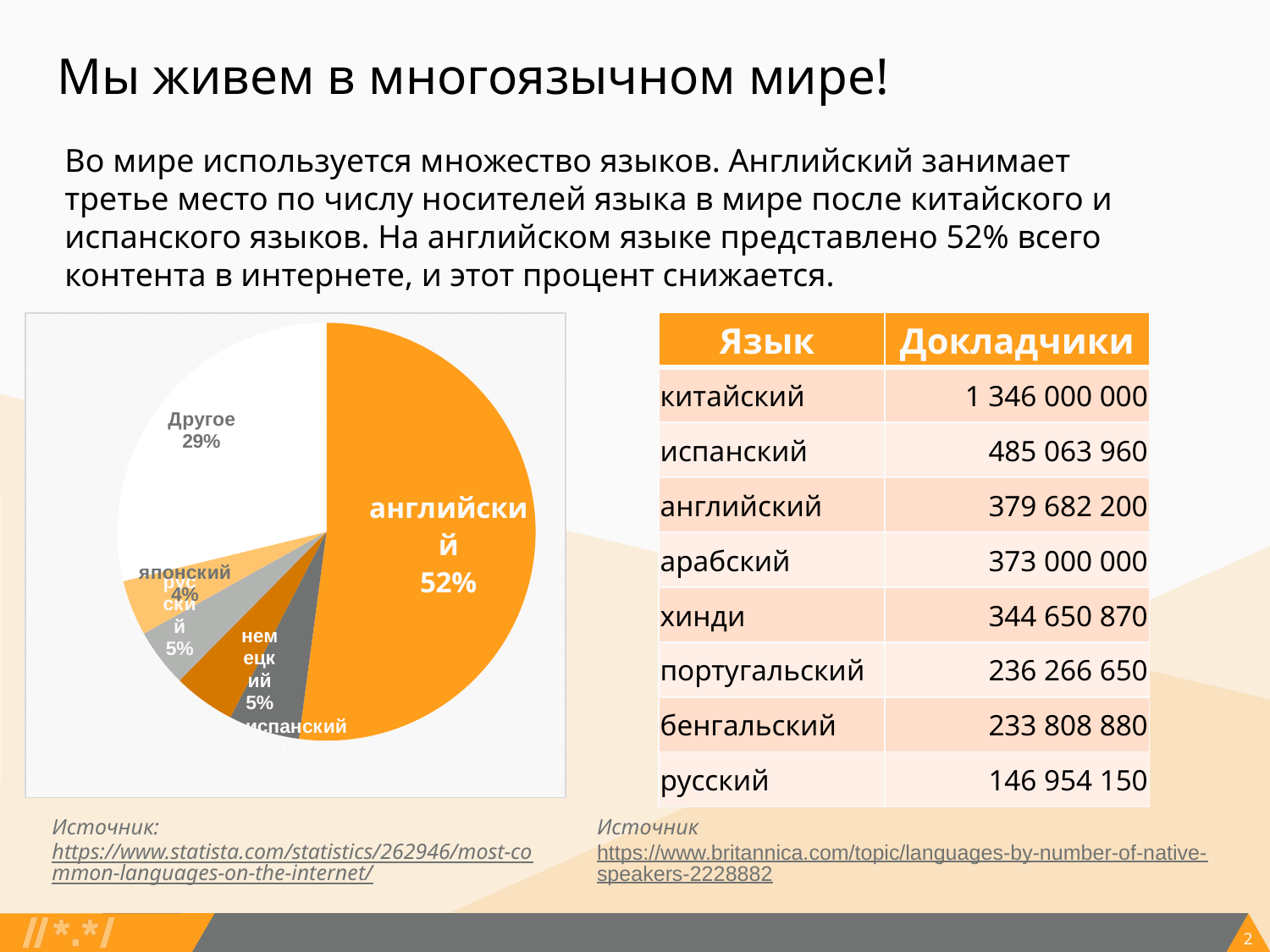
Which slice of the pie chart is the largest? английский Which is larger in the pie chart, английский or Другое? английский What type of chart is shown on the left of the slide? Pie chart What percentage is shown for the Другое (Other) slice of the pie chart? 29% What percentage is shown for русский (Russian) in the pie chart? 5% How many slices does the pie chart have? 6 By how many percentage points does английский exceed Другое in the pie chart? 23% By how many percentage points does Другое exceed японский in the pie chart? 25% What percentage is shown for немецкий (German) in the pie chart? 5% What percentage is shown for японский (Japanese) in the pie chart? 4% What share of the pie chart does английский (English) account for? 52% Which is larger in the pie chart, Другое or русский? Другое